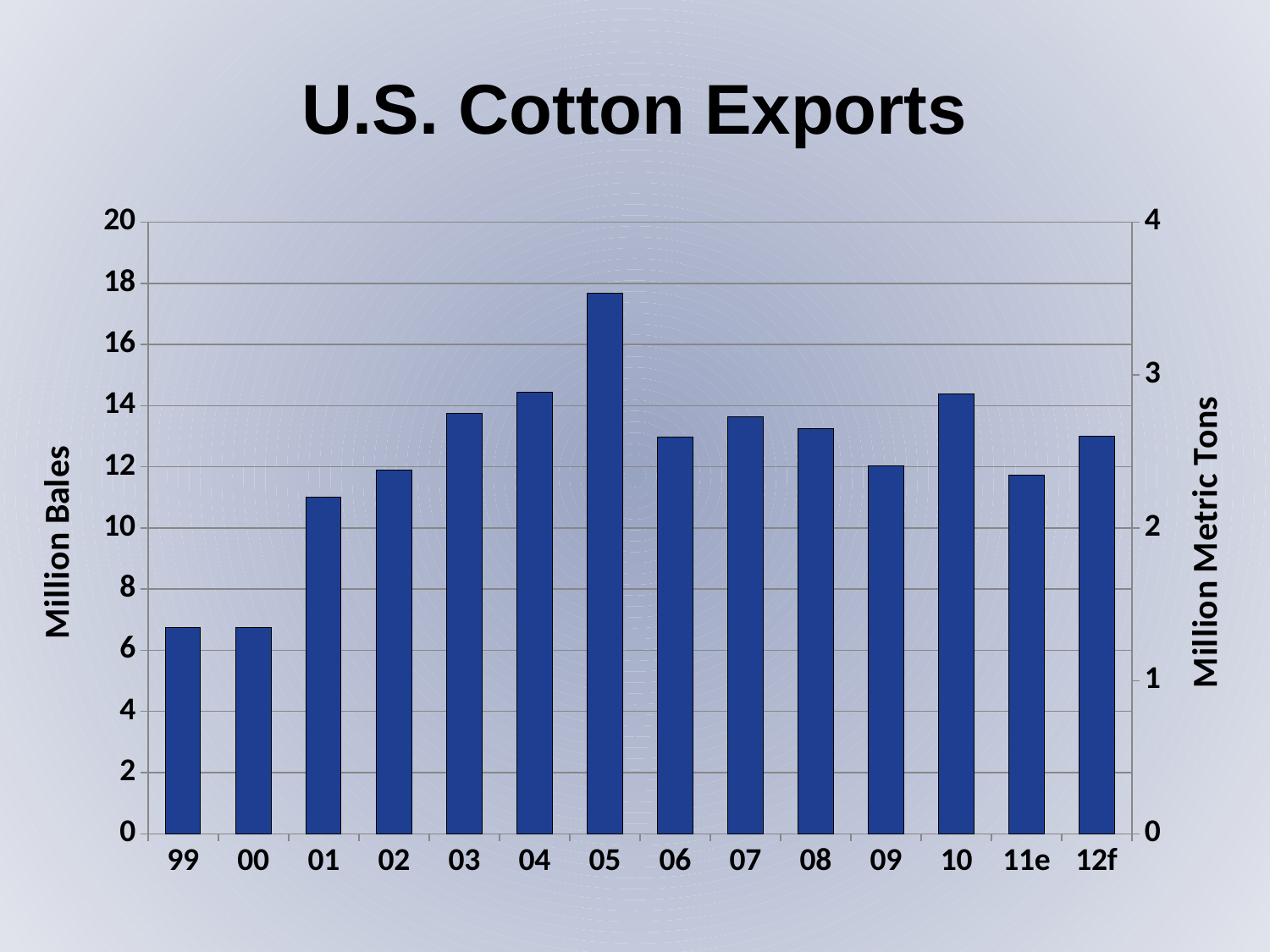
What type of chart is shown on the slide? bar chart Do the values generally rise or fall from 99 to 05? rise Which is larger, the value for 05 or the value for 10? 05 How many years (categories) are shown on the x axis? 14 Is the value for 99 greater or less than 8 million bales? less Is the value for 01 greater or less than 10 million bales? greater Which is larger, the value for 04 or the value for 09? 04 Is the value for 05 greater or less than 16 million bales? greater Which year has the highest cotton exports? 05 What is the label of the left vertical axis? Million Bales What is the title of the chart? U.S. Cotton Exports